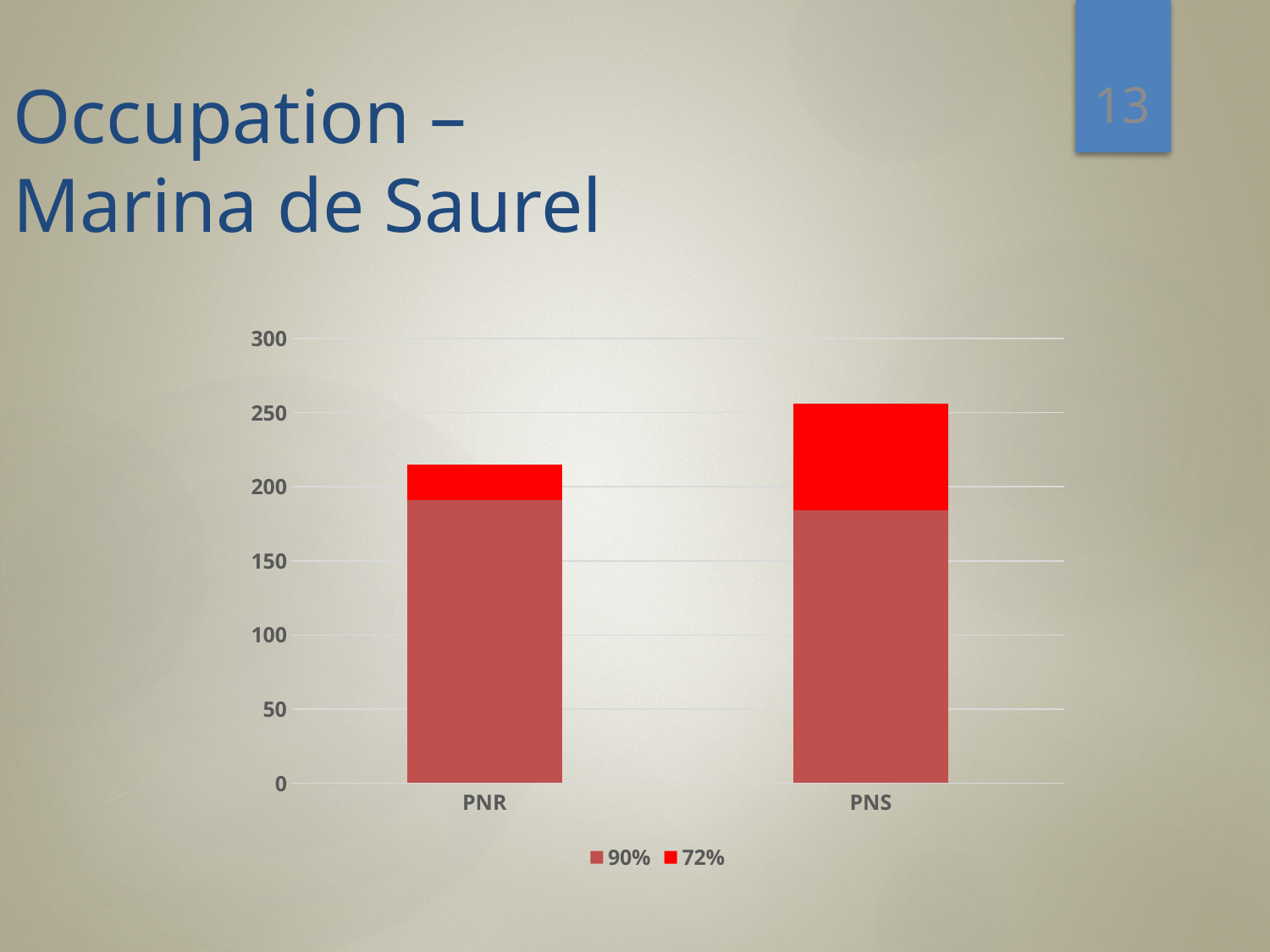
How many series does the chart's legend list? 2 Is the total stacked value for PNS greater or less than 300? less Is the total stacked value for PNR greater or less than 200? greater Which category has the larger 72% segment, PNR or PNS? PNS Is the total stacked value for PNS greater or less than 200? greater What are the two entries listed in the chart's legend? 90% and 72% What kind of chart is shown on the slide? bar chart What is the title of the slide containing the chart? Occupation – Marina de Saurel Which category has the shorter stacked bar? PNR How many categories are shown on the x axis of the chart? 2 Which category has the taller stacked bar, PNR or PNS? PNS